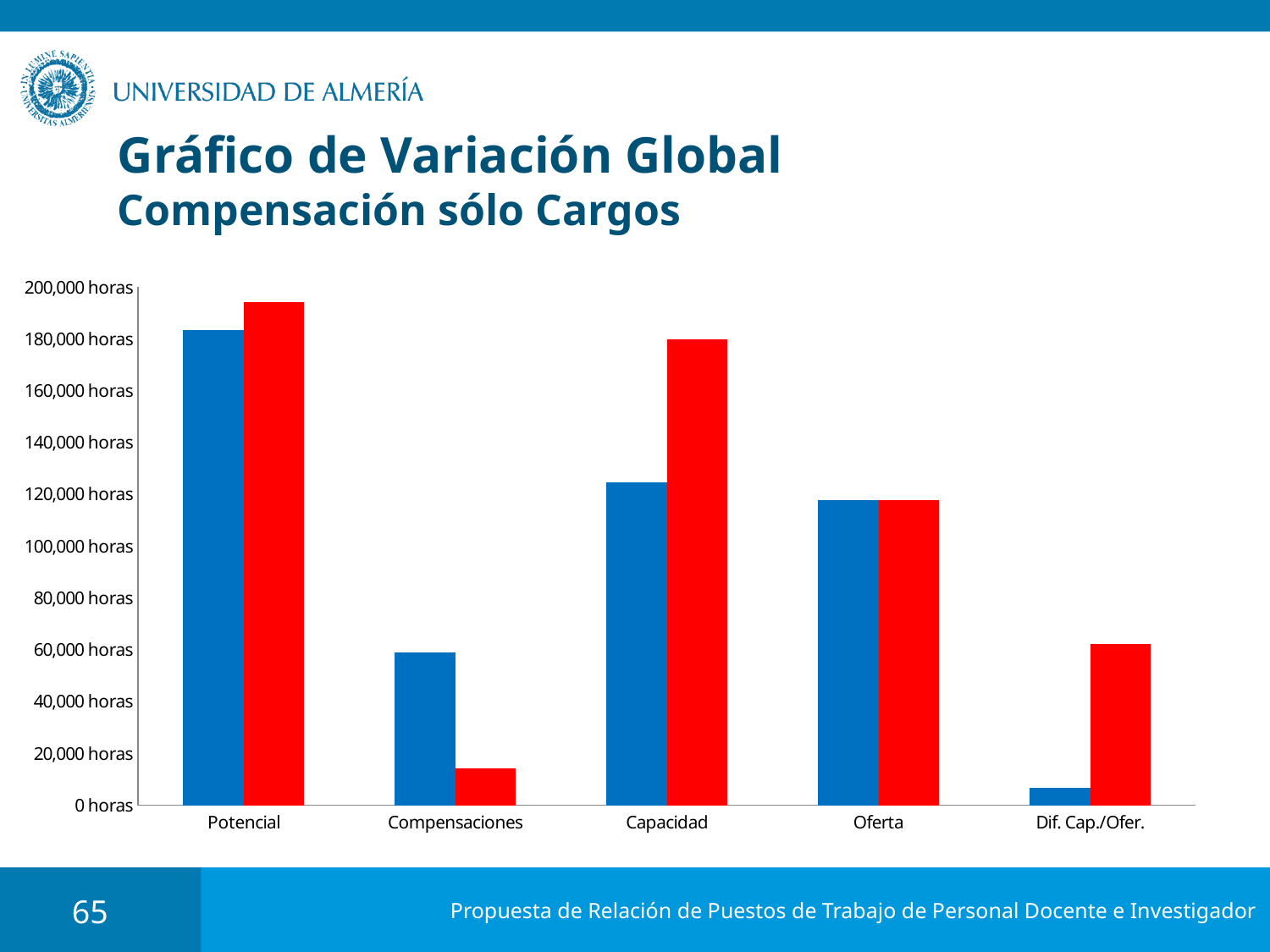
Which category has the shortest blue bar? Dif. Cap./Ofer. Is the blue bar for Compensaciones greater or less than 40,000 horas? greater Which category has the shortest red bar? Compensaciones How many categories are shown on the x axis of the chart? 5 What kind of chart is shown on the slide? bar chart For Compensaciones, which bar is taller, the blue one or the red one? the blue one For Capacidad, which bar is taller, the blue one or the red one? the red one Is the red bar for Capacidad greater or less than 160,000 horas? greater Which category has the tallest blue bar? Potencial Which category has the tallest red bar? Potencial What is the title of the chart on the slide? Gráfico de Variación Global Compensación sólo Cargos Is the blue bar for Dif. Cap./Ofer. greater or less than 20,000 horas? less